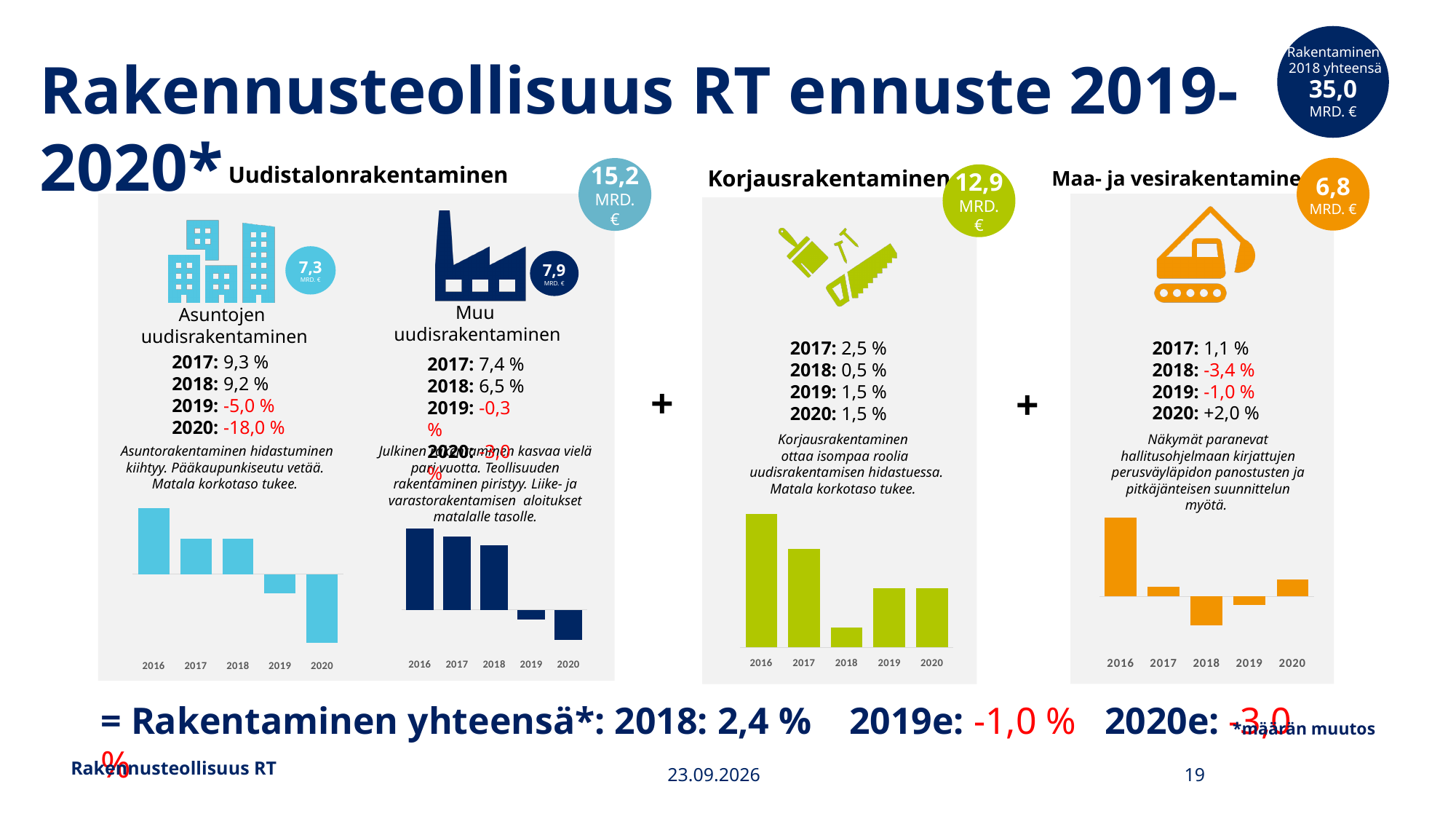
What colour are the bars in the Korjausrakentaminen chart? green In the Asuntojen uudisrakentaminen panel, what is the value for 2019? -5,0 % In the Maa- ja vesirakentaminen panel, what is the value for 2020? +2,0 % In the Asuntojen uudisrakentaminen chart, how many years are shown on the x axis? 5 In the Maa- ja vesirakentaminen chart, which is larger, the value for 2018 or the value for 2020? 2020 What kind of chart is shown under Asuntojen uudisrakentaminen? bar chart In the Asuntojen uudisrakentaminen chart, which year has the lowest bar? 2020 In the Korjausrakentaminen chart, which year has the lowest bar? 2018 In the Korjausrakentaminen panel, what is the value for 2018? 0,5 % In the Asuntojen uudisrakentaminen chart, which year has the highest bar? 2016 In the Korjausrakentaminen panel, what is the difference between the 2017 and 2018 values? 2,0 % In the Muu uudisrakentaminen chart, do the bars rise or fall from 2016 to 2020? fall